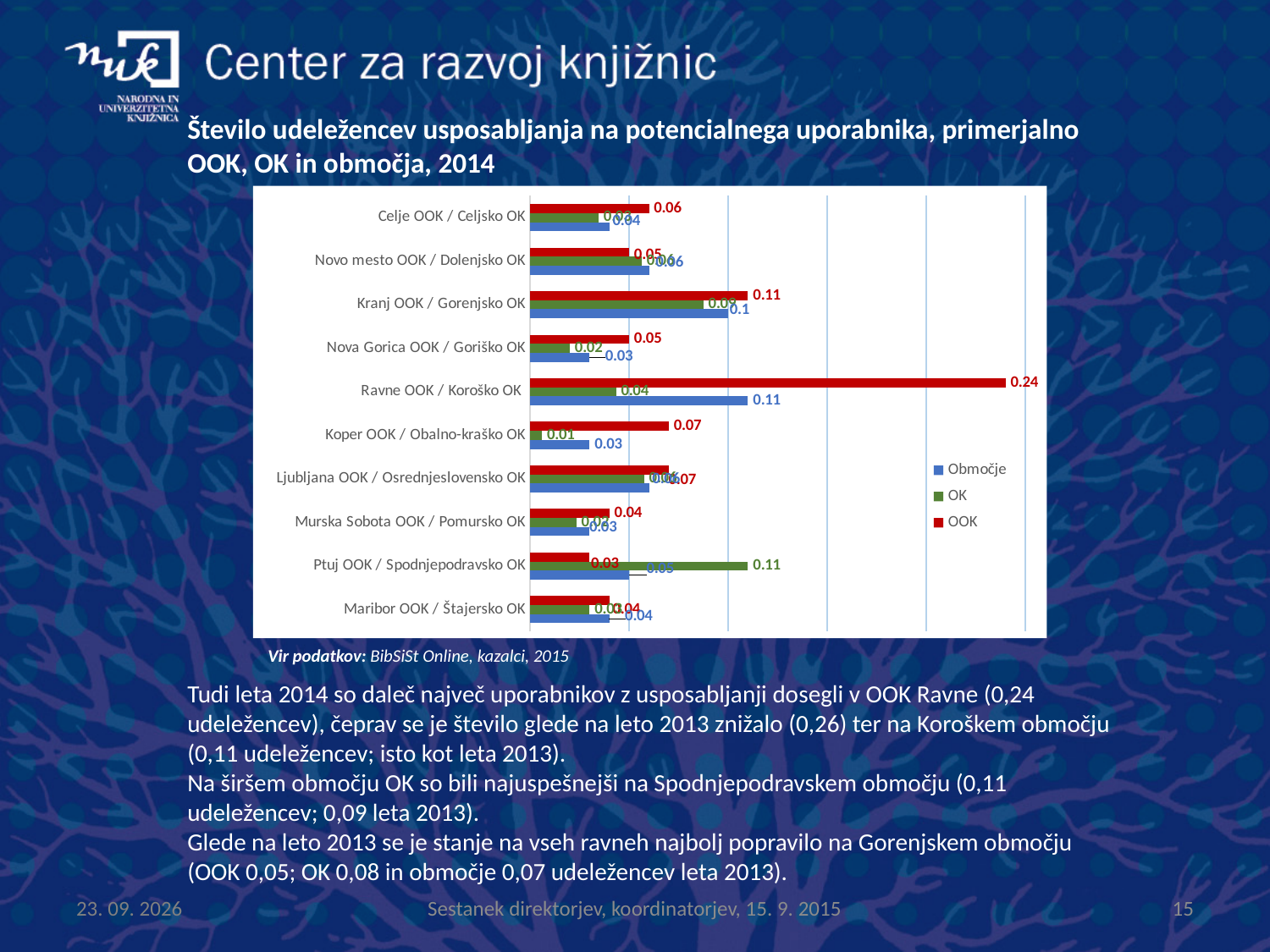
For Ptuj OOK / Spodnjepodravsko OK, which is larger: the OK value or the OOK value? OK How many categories (library pairs) are shown on the chart? 10 Which category has the lowest OK value? Koper OOK / Obalno-kraško OK What is the difference between the OOK value and the Območje value for Ravne OOK / Koroško OK? 0.13 What kind of chart is shown on the slide? bar chart What colour represents the OOK series in the legend? red How many series does the legend list? 3 What is the OOK value for Ravne OOK / Koroško OK? 0.24 What is the Območje value for Kranj OOK / Gorenjsko OK? 0.1 What is the OK value for Ptuj OOK / Spodnjepodravsko OK? 0.11 What is the OK value for Nova Gorica OOK / Goriško OK? 0.02 Which category has the highest OOK value? Ravne OOK / Koroško OK